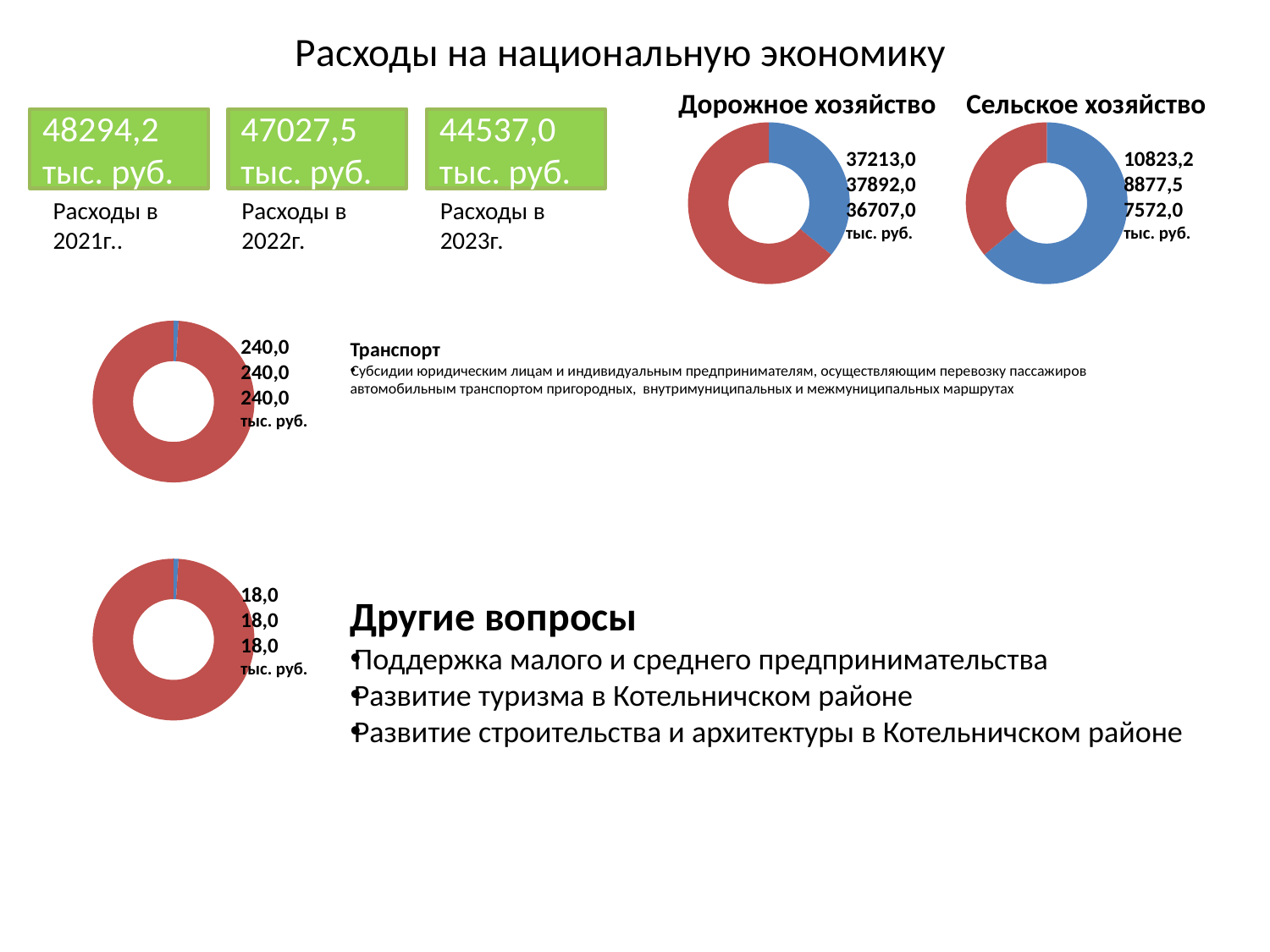
In the Сельское хозяйство chart, what is the difference between 10823,2 and 7572,0? 3251,2 In the Сельское хозяйство chart, which is larger: 10823,2 or 8877,5? 10823,2 In the Дорожное хозяйство chart, what is the difference between the highest listed value (37892,0) and the lowest (36707,0)? 1185,0 In the Сельское хозяйство chart, which of the three listed values is the lowest? 7572,0 In the Дорожное хозяйство chart, which of the three listed values is the highest? 37892,0 In the Дорожное хозяйство chart, which of the three listed values is the lowest? 36707,0 What unit is shown for the values next to the Другие вопросы doughnut chart? тыс. руб. What kind of chart is used for Дорожное хозяйство? doughnut chart What value is repeated three times next to the Транспорт doughnut chart? 240,0 How many values are listed next to the Сельское хозяйство chart? 3 In the Сельское хозяйство chart, which of the three listed values is the highest? 10823,2 In the Дорожное хозяйство chart, what is the first value listed? 37213,0